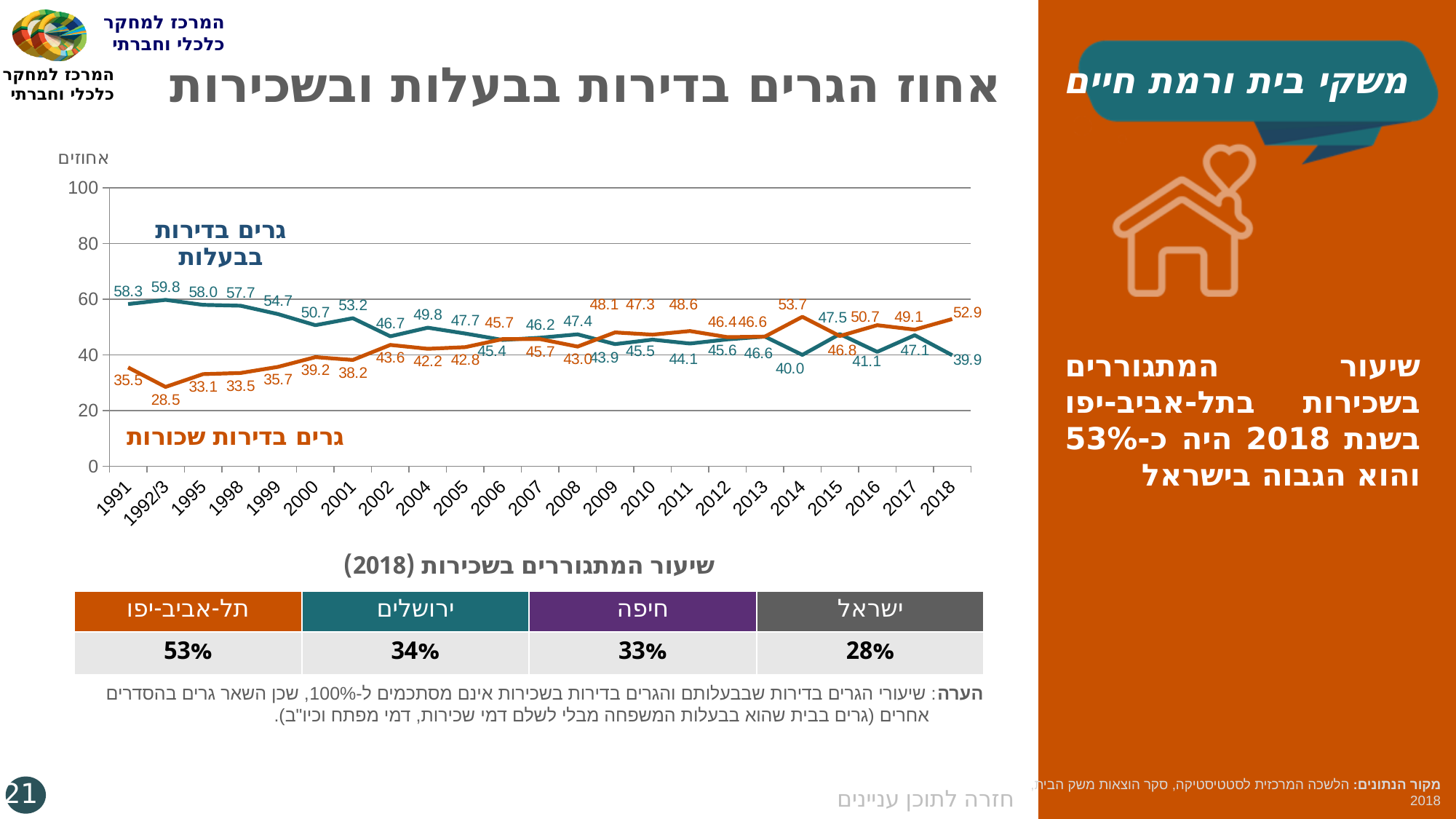
What type of chart is shown on the slide? line chart Which colour is used for the line for living in rented apartments (גרים בדירות שכורות)? orange What is the value for living in rented apartments (גרים בדירות שכורות) in 2018? 52.9 In which year is the value for living in rented apartments (גרים בדירות שכורות) lowest? 1992/3 In 2018, which series has the larger value: living in owned apartments or living in rented apartments? living in rented apartments (גרים בדירות שכורות) How many years are plotted along the x axis of the chart? 23 What is the value for living in owned apartments (גרים בדירות בבעלות) in 1991? 58.3 In which year is the value for living in owned apartments (גרים בדירות בבעלות) highest? 1992/3 What is the value for living in rented apartments (גרים בדירות שכורות) in 2014? 53.7 Does the value for living in owned apartments (גרים בדירות בבעלות) generally rise or fall from 1991 to 2018? fall What is the difference between the owned-apartment value (58.3) and the rented-apartment value (35.5) in 1991? 22.8 How many series does the chart show? 2